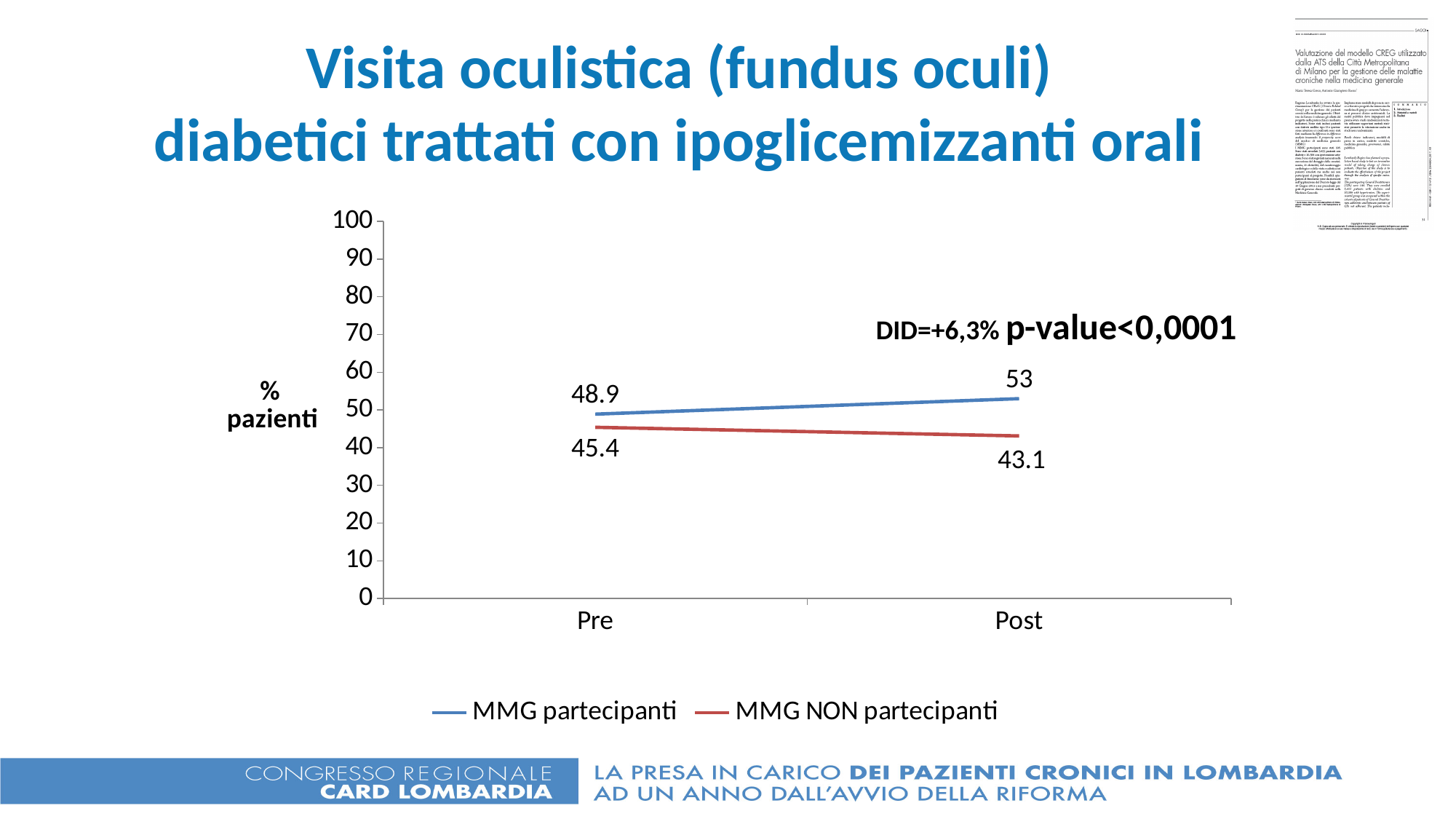
What is the value for MMG partecipanti at Pre? 48.9 What is the value for MMG partecipanti at Post? 53 What is the value for MMG NON partecipanti at Pre? 45.4 How many series does the legend list? 2 What kind of chart is shown on the slide? line chart Does the value for MMG NON partecipanti rise or fall from Pre to Post? fall What is the value for MMG NON partecipanti at Post? 43.1 Does the value for MMG partecipanti rise or fall from Pre to Post? rise Which series has the higher value at Post? MMG partecipanti What is the difference between MMG partecipanti and MMG NON partecipanti at Post? 9.9 By how much did the value for MMG partecipanti change from Pre to Post? 4.1 What DID value is annotated on the chart? +6,3%